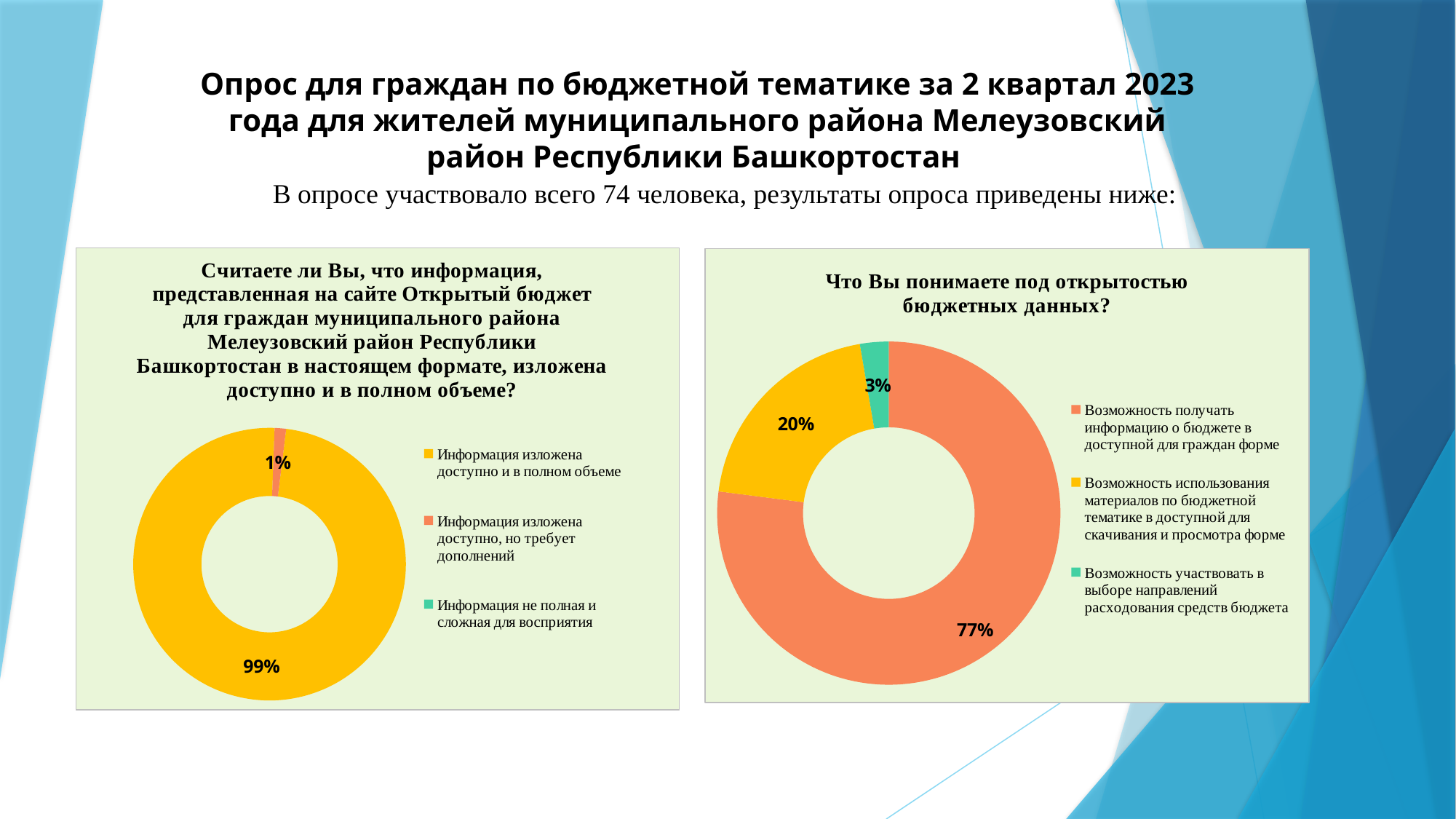
On the right chart, what share corresponds to "Возможность использования материалов по бюджетной тематике в доступной для скачивания и просмотра форме"? 20% On the right chart "Что Вы понимаете под открытостью бюджетных данных?", what share corresponds to "Возможность получать информацию о бюджете в доступной для граждан форме"? 77% On the right chart, which colour represents the 20% slice? Yellow On the left chart, what share of respondents answered "Информация изложена доступно и в полном объеме"? 99% On the right chart, which answer has the smallest share? Возможность участвовать в выборе направлений расходования средств бюджета On the right chart, what is the difference in percentage points between the 77% slice and the 20% slice? 57 What type of chart is the left chart? Doughnut chart On the right chart, what share corresponds to "Возможность участвовать в выборе направлений расходования средств бюджета"? 3% How many entries does the legend of the left chart list? 3 On the left chart, what share of respondents answered "Информация изложена доступно, но требует дополнений"? 1% On the left chart, what is the difference in percentage points between the 99% and 1% slices? 98 On the left chart, which answer has the largest share? Информация изложена доступно и в полном объеме